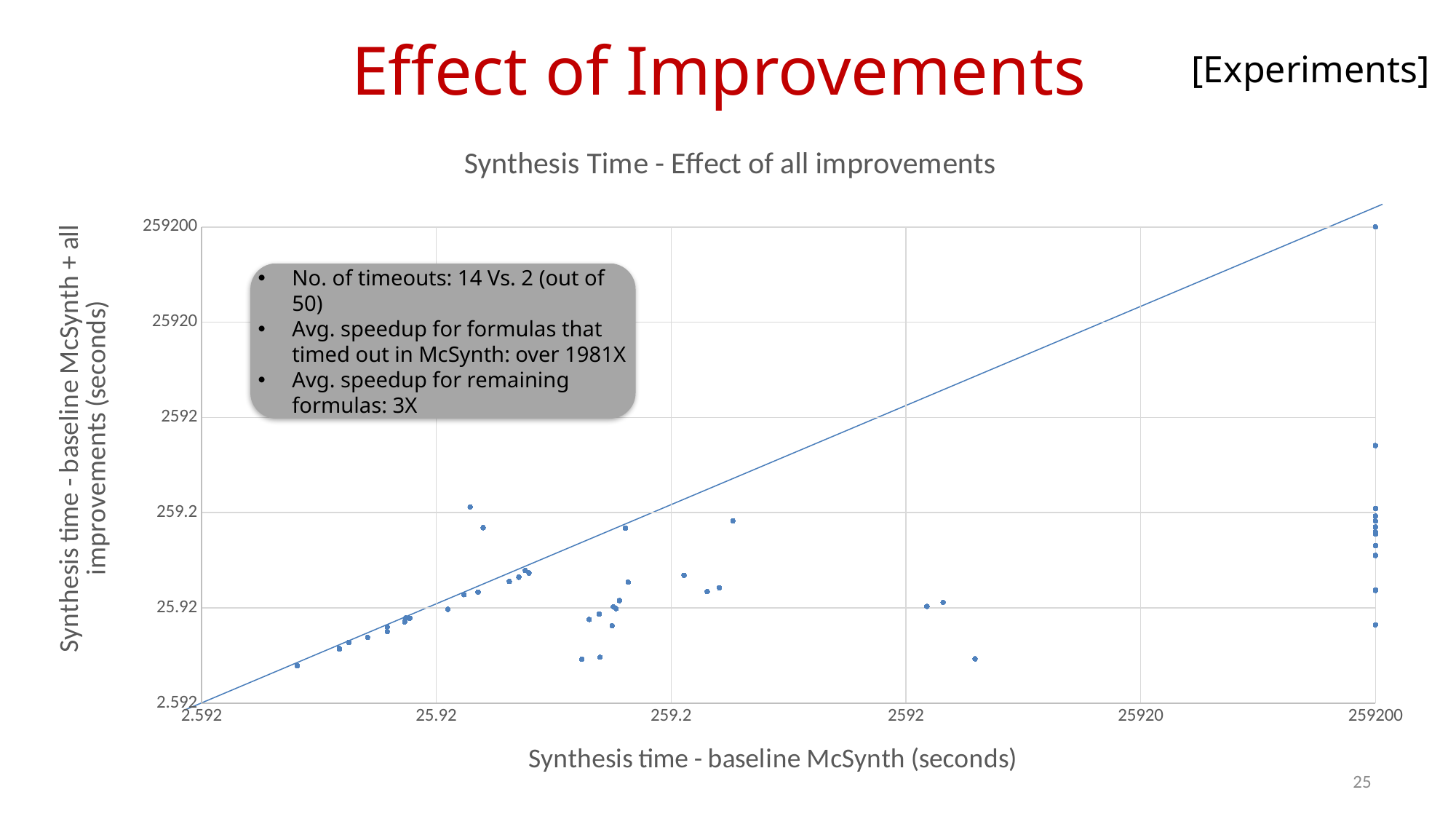
How many tick labels are shown on the x axis? 6 What is the lowest tick label on the y axis? 2.592 What is the title of the x axis? Synthesis time - baseline McSynth (seconds) Is the x value of the leftmost point greater or less than 25.92? less What is the title of the chart? Synthesis Time - Effect of all improvements Is the y value of the topmost point greater or less than 25920? greater What kind of chart is shown on the slide? scatter chart What is the y value of the highest point on the chart? 259200 Is the y value of the lowest point greater or less than 25.92? less What is the x value of the rightmost column of points? 259200 Do most of the points lie above or below the diagonal reference line? below